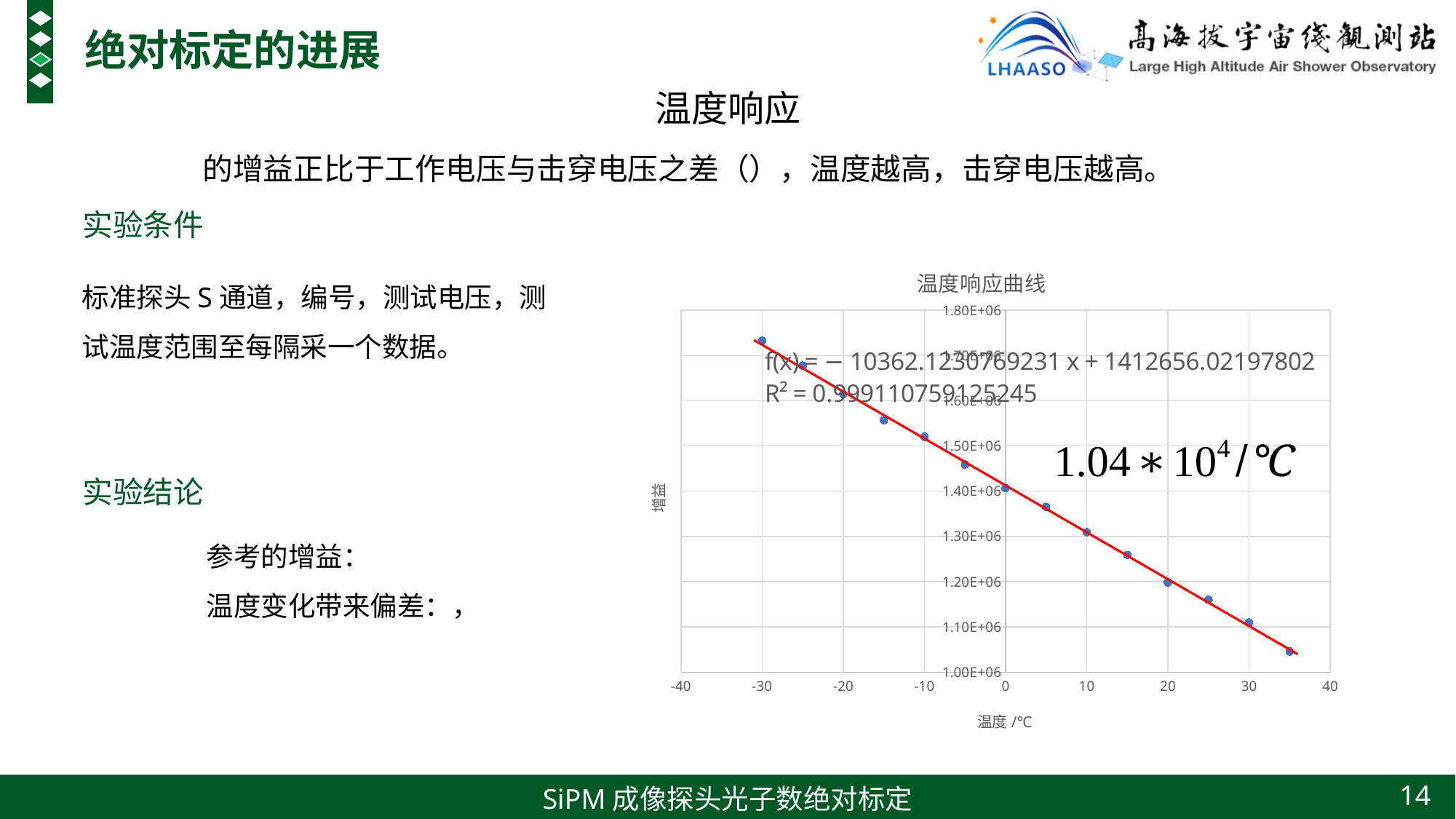
What kind of chart is shown under the title 温度响应曲线? scatter chart In the 温度响应曲线 chart, is the gain at temperature 35 greater or less than 1.10E+06? less In the 温度响应曲线 chart, do the gain values rise or fall as temperature increases along the x axis? fall In the 温度响应曲线 chart, at which temperature is the gain lowest? 35 In the 温度响应曲线 chart, is the gain at temperature -15 greater or less than 1.60E+06? less In the 温度响应曲线 chart, is the gain at temperature -30 greater or less than 1.70E+06? greater In the 温度响应曲线 chart, which has the larger gain: the point at -30 or the point at 35? -30 What is the label of the x axis of the 温度响应曲线 chart? 温度 /℃ In the 温度响应曲线 chart, at which temperature is the gain highest? -30 What is the R² value printed on the 温度响应曲线 chart? 0.999110759125245